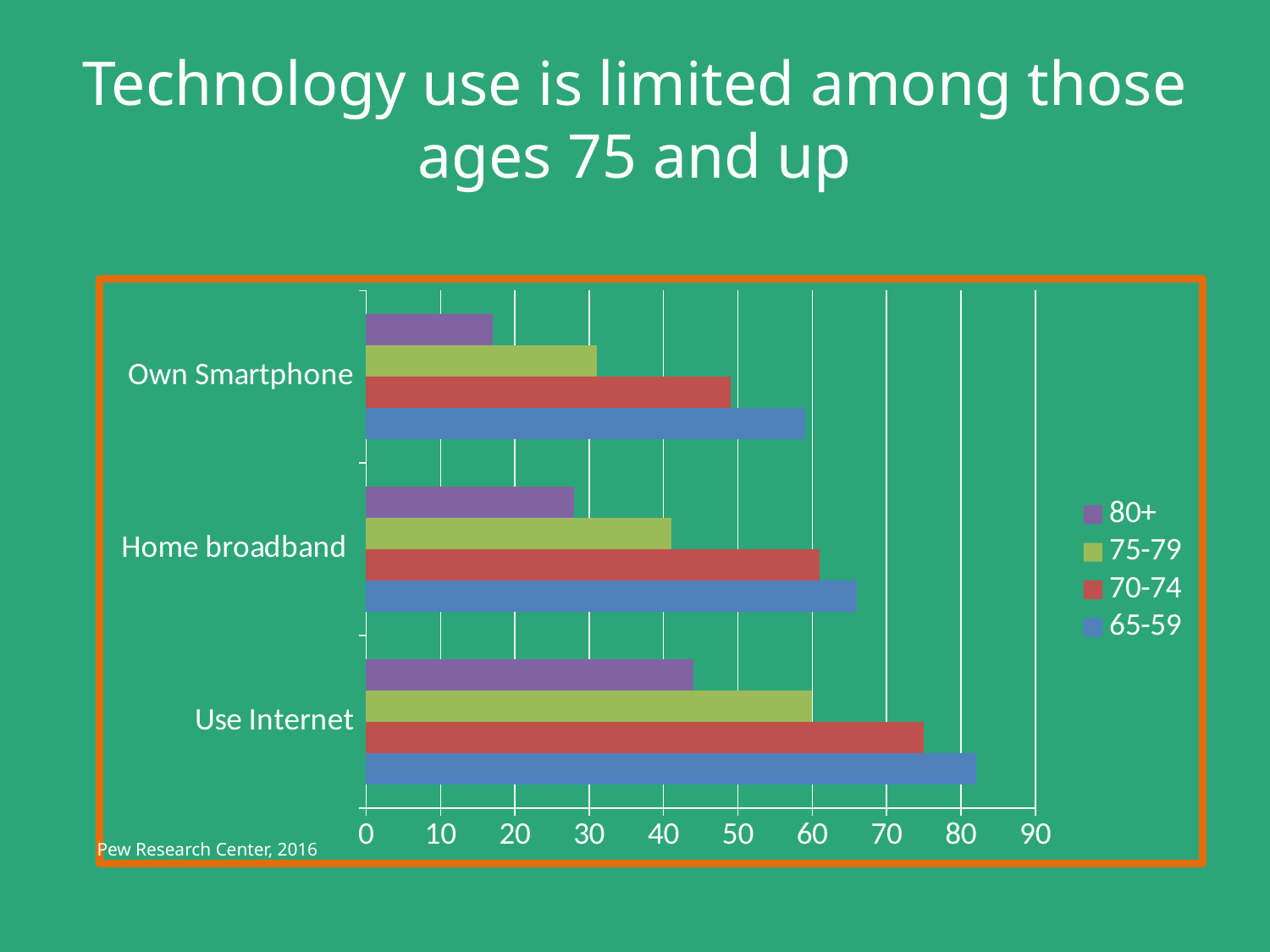
Is the value for the 75-79 group for Own Smartphone greater or less than 40? less Which is larger for the 70-74 group: Own Smartphone or Home broadband? Home broadband How many categories are shown on the vertical axis? 3 Which age group has the lowest value for Own Smartphone? 80+ Is the value for the 65-59 group for Use Internet greater or less than 70? greater What colour represents the 80+ group in the legend? purple Which age group has the highest value for Use Internet? 65-59 What kind of chart is shown on the slide? bar chart How many series does the legend list? 4 Which category has the longest bar overall in the chart? Use Internet Is the value for the 70-74 group for Home broadband greater or less than 50? greater